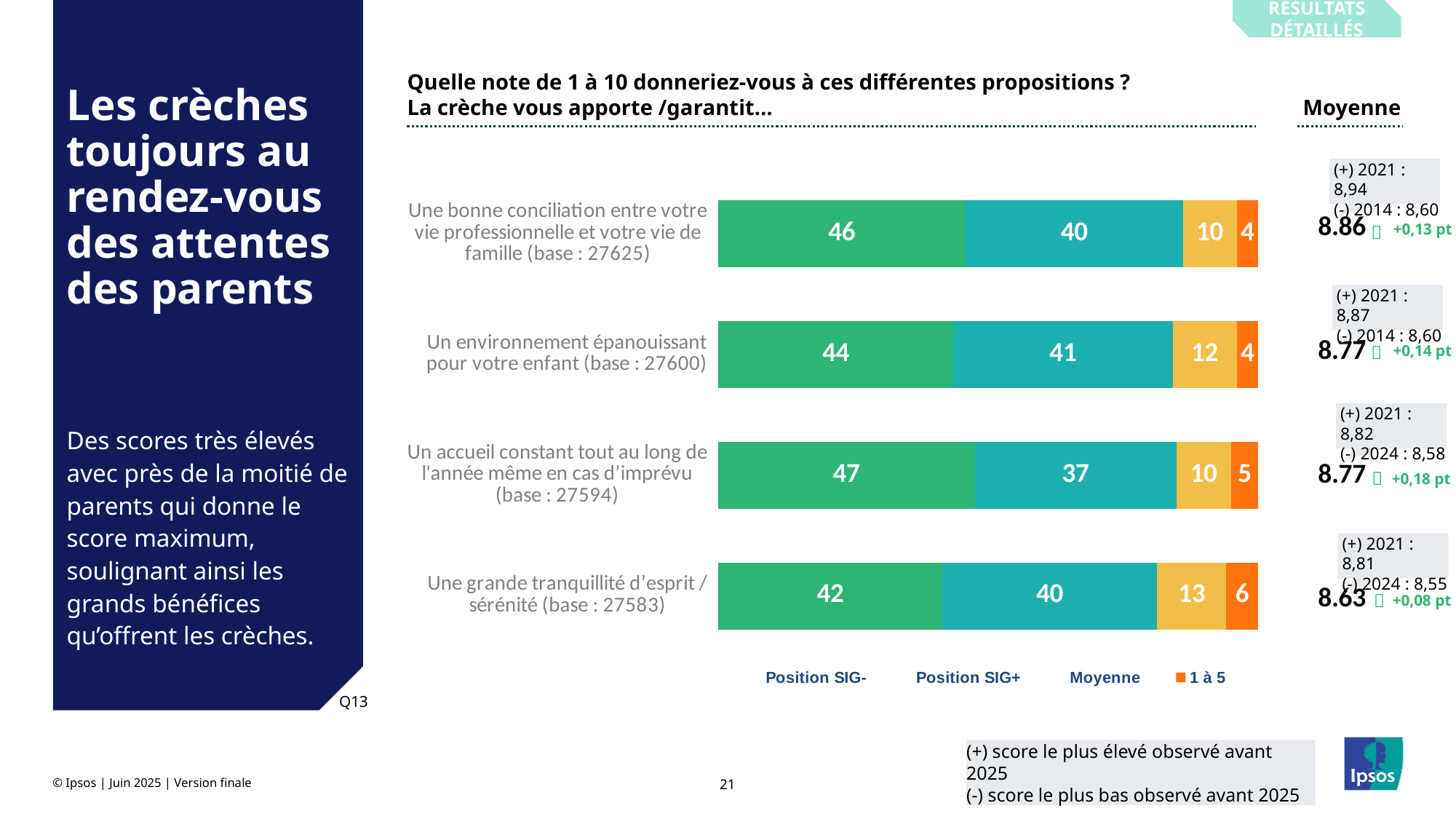
What is the "Moyenne" (mean score) shown for "Une grande tranquillité d'esprit / sérénité"? 8.63 Which category has the lowest value in its first (leftmost) segment? Une grande tranquillité d'esprit / sérénité What is the value of the second segment for "Un environnement épanouissant pour votre enfant"? 41 Which category has the highest "Moyenne" (mean score)? Une bonne conciliation entre votre vie professionnelle et votre vie de famille What is the value of the last (orange) segment for "Une grande tranquillité d'esprit / sérénité"? 6 Which is larger: the third segment for "Une grande tranquillité d'esprit / sérénité" or the third segment for "Un environnement épanouissant pour votre enfant"? Une grande tranquillité d'esprit / sérénité What is the difference between the first-segment values of "Un accueil constant tout au long de l'année" (47) and "Une grande tranquillité d'esprit / sérénité" (42)? 5 What is the value of the first (leftmost) segment for "Une bonne conciliation entre votre vie professionnelle et votre vie de famille"? 46 What kind of chart is shown on the slide? Stacked bar chart Which category has the highest value in its first (leftmost) segment? Un accueil constant tout au long de l'année même en cas d'imprévu How many categories (bars) are shown in the chart? 4 What is the total of the segments in the bar for "Une bonne conciliation entre votre vie professionnelle et votre vie de famille"? 100